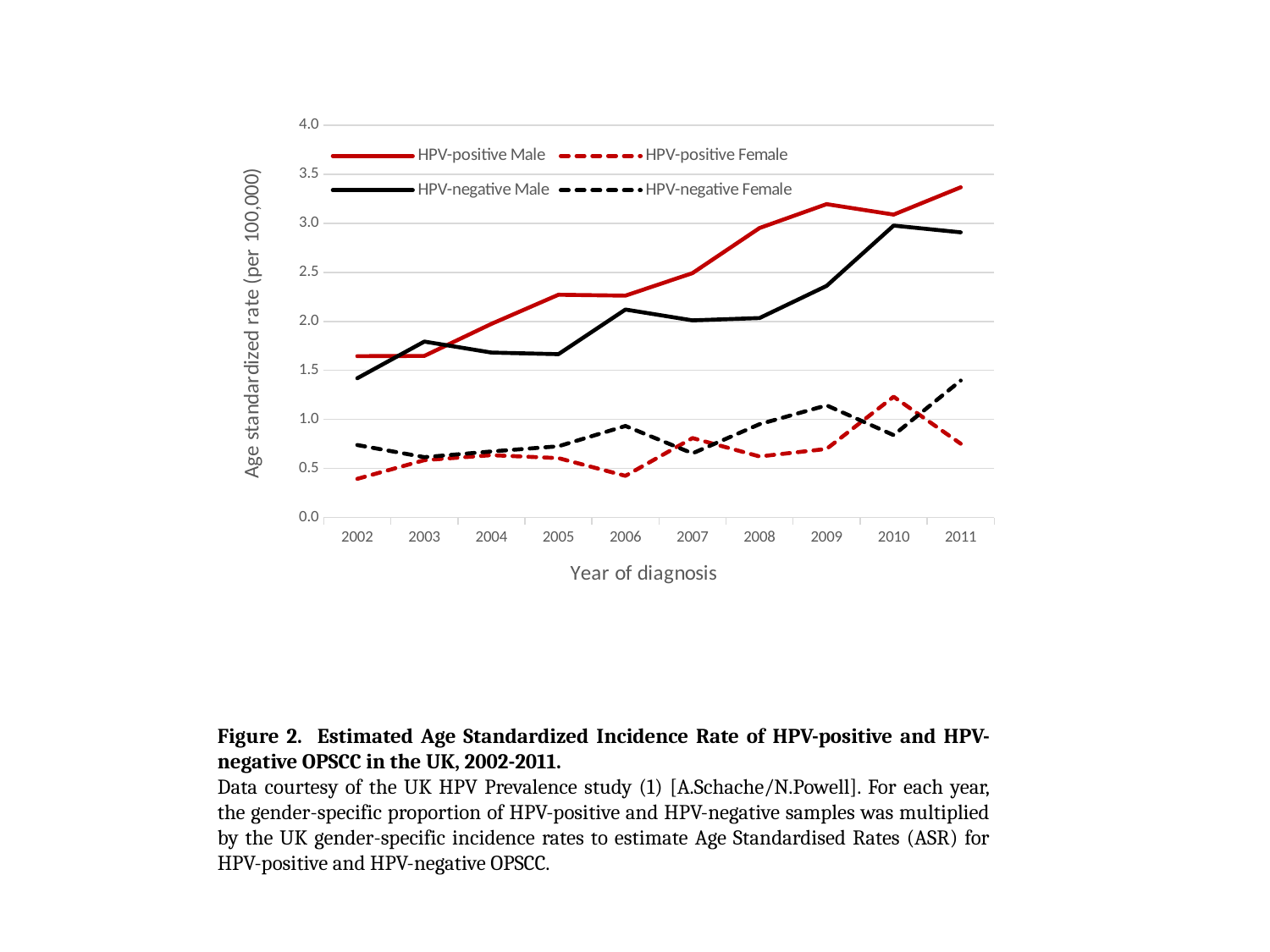
In which year is the HPV-positive Male series at its highest? 2011 Is the value for HPV-positive Female in 2002 greater or less than 0.5? less Is the value for HPV-positive Male in 2008 greater or less than 2.5? greater In 2011, which is larger: HPV-positive Male or HPV-negative Male? HPV-positive Male Is the value for HPV-positive Male in 2011 greater or less than 3.0? greater In 2010, which is larger: HPV-positive Female or HPV-negative Female? HPV-positive Female What is the label of the x axis? Year of diagnosis How many series does the legend list? 4 What kind of chart is shown on the slide? Line chart Does the HPV-positive Male series generally rise or fall from 2002 to 2011? Rise How many years are plotted along the x axis? 10 What is the label of the y axis? Age standardized rate (per 100,000)